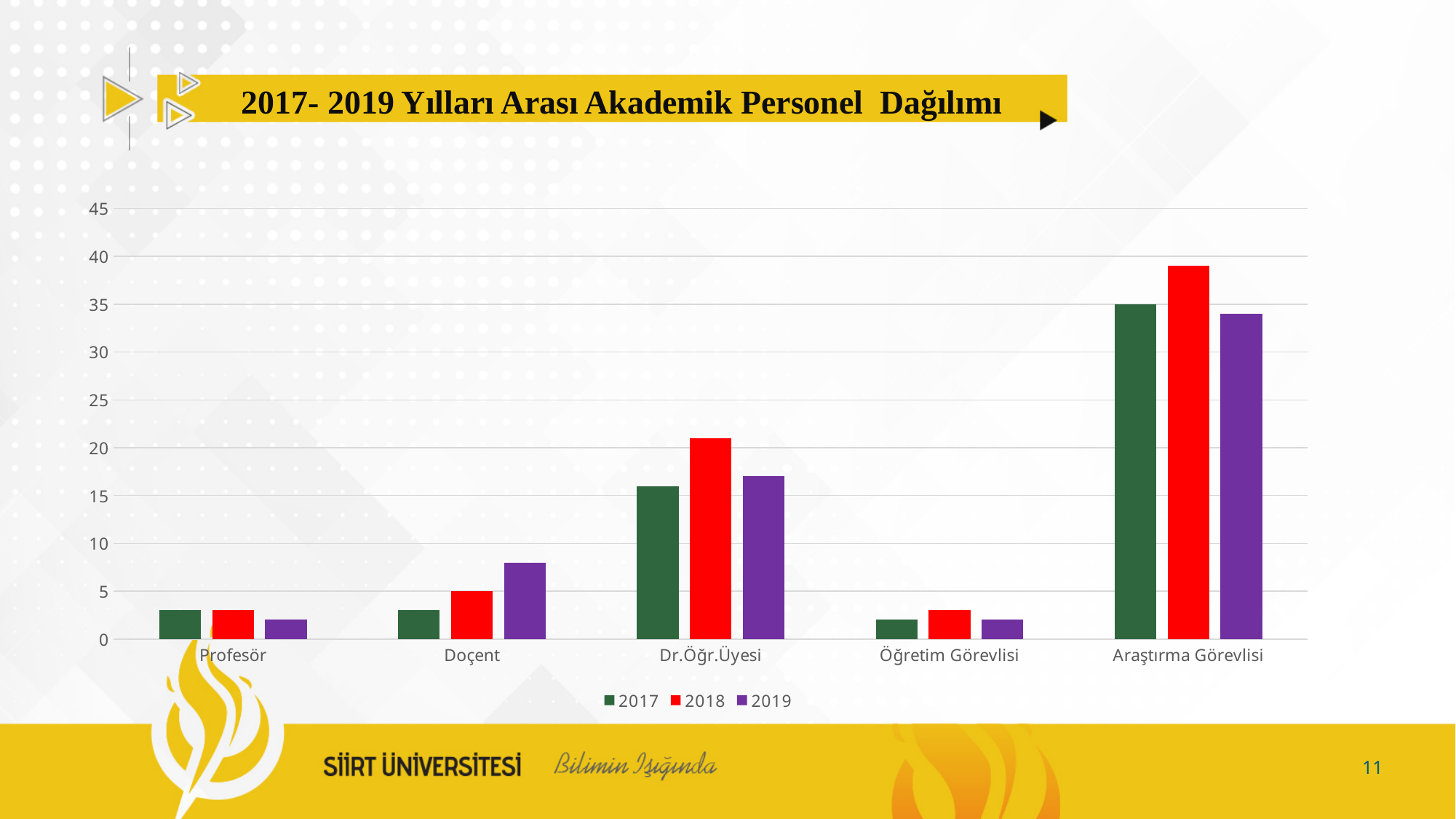
What is the value for Doçent in 2018? 5 What is the value for Araştırma Görevlisi in 2017? 35 Is the value for Araştırma Görevlisi in 2019 greater or less than 30? greater What is the title of the chart? 2017- 2019 Yılları Arası Akademik Personel Dağılımı For Dr.Öğr.Üyesi, which year has the larger value, 2017 or 2018? 2018 What kind of chart is shown on the slide? bar chart How many series does the legend list? 3 How many categories are shown on the x axis? 5 Which category has the highest value for 2018? Araştırma Görevlisi Is the value for Dr.Öğr.Üyesi in 2018 greater or less than 20? greater Is the value for Doçent in 2019 greater or less than 10? less Which category has the lowest value for 2017? Öğretim Görevlisi